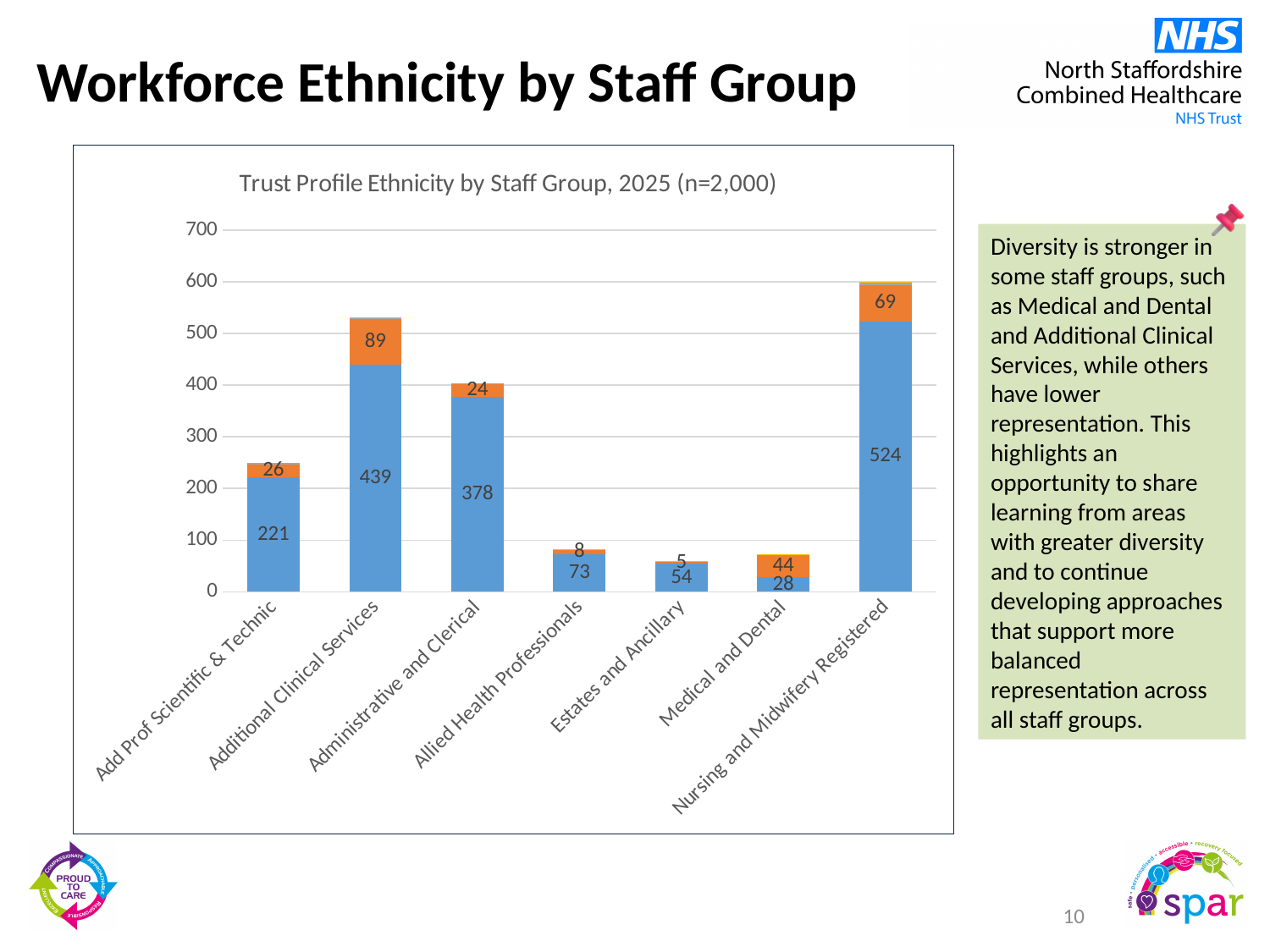
What is the value of the orange segment for Additional Clinical Services? 89 What is the difference between the blue segment values for Nursing and Midwifery Registered and Additional Clinical Services? 85 Which staff group has the largest blue segment? Nursing and Midwifery Registered How many staff groups are shown on the x axis of the chart? 7 For Medical and Dental, which segment is larger, the blue or the orange? Orange Which staff group has the smallest orange segment? Estates and Ancillary What is the value of the blue segment for Nursing and Midwifery Registered? 524 Is the total bar height for Nursing and Midwifery Registered greater or less than 500? greater What kind of chart is shown on the slide? Stacked bar chart What is the value of the blue segment for Medical and Dental? 28 Is the total bar height for Allied Health Professionals greater or less than 100? less What is the title of the chart? Trust Profile Ethnicity by Staff Group, 2025 (n=2,000)